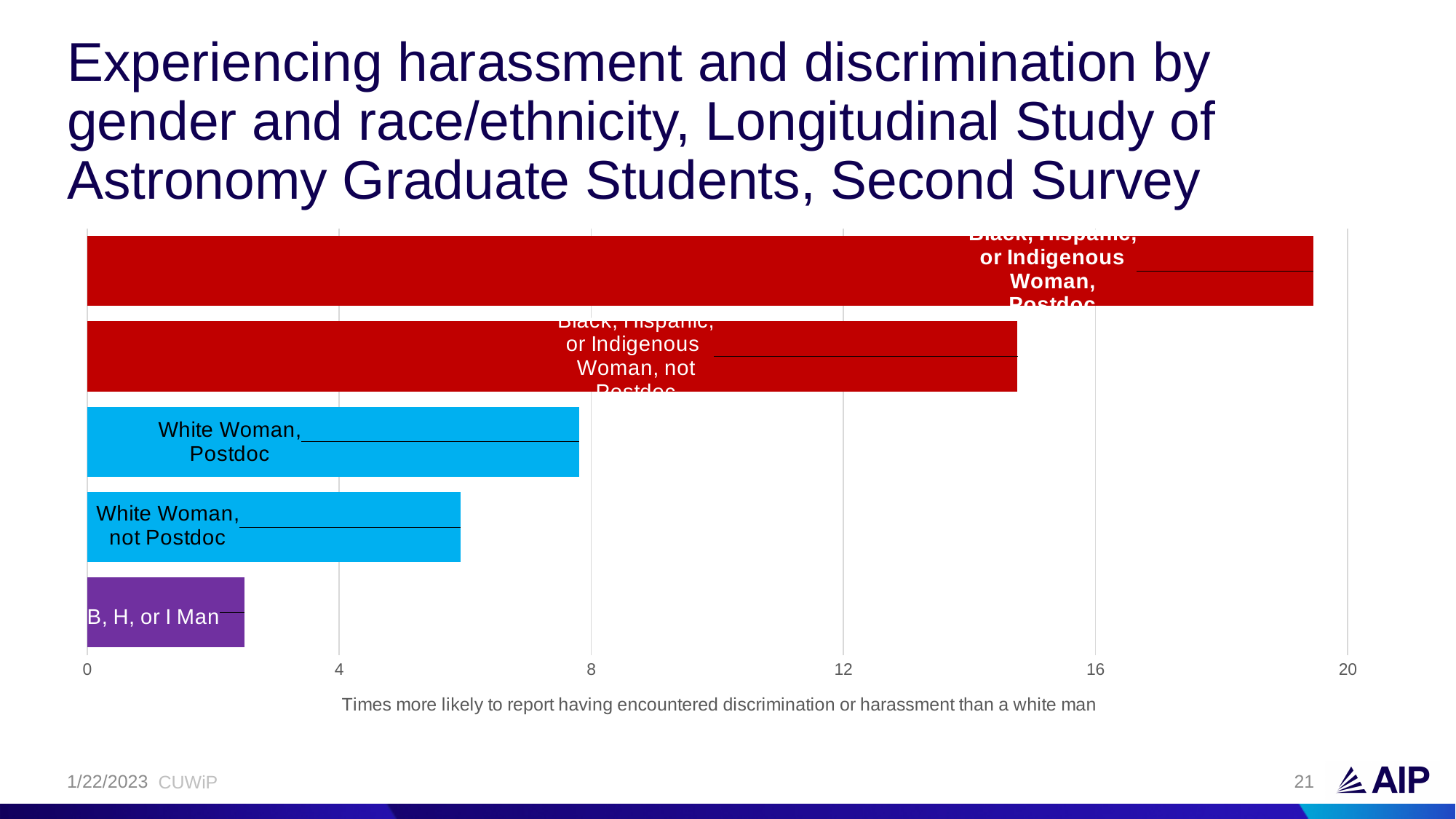
Which category has the lowest value in the chart? B, H, or I Man Which category has the highest value in the chart? Black, Hispanic, or Indigenous Woman, Postdoc Is the value for Black, Hispanic, or Indigenous Woman, Postdoc greater or less than 16? greater How many bars (categories) does the chart show? 5 Is the value for White Woman, not Postdoc greater or less than 4? greater Is the value for B, H, or I Man greater or less than 4? less What kind of chart is shown on the slide? bar chart Which is larger: the value for White Woman, Postdoc or the value for White Woman, not Postdoc? White Woman, Postdoc What colour is the bar for B, H, or I Man? purple What is the label on the horizontal axis of the chart? Times more likely to report having encountered discrimination or harassment than a white man